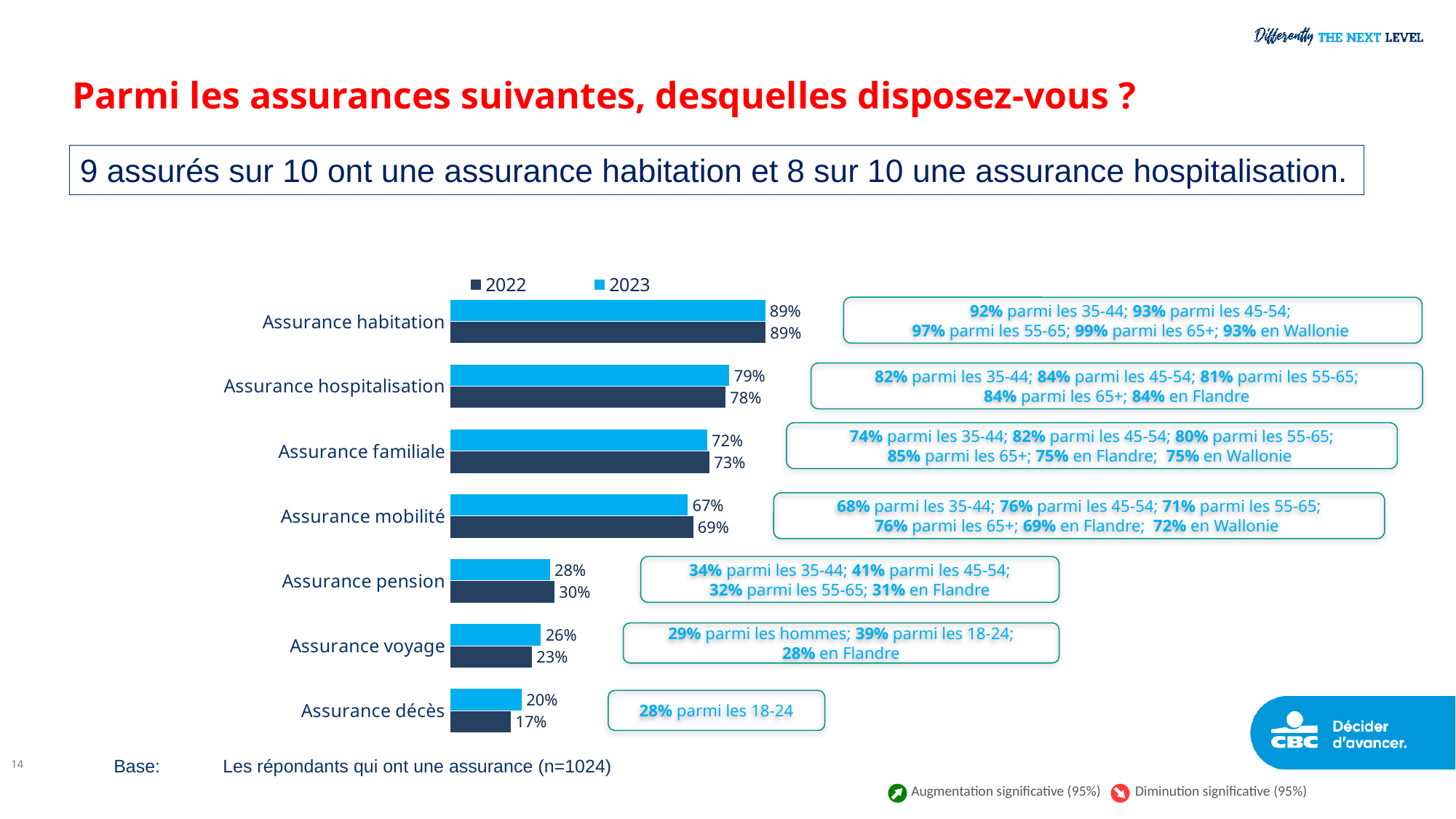
Which category has the highest 2023 value? Assurance habitation Which category has the lowest 2022 value? Assurance décès How many series does the legend list? 2 What is the 2023 value for Assurance hospitalisation? 79% What is the difference between the 2022 and 2023 values for Assurance voyage? 3% What is the 2022 value for Assurance pension? 30% What kind of chart is shown on the slide? Bar chart How many categories does the chart show? 7 Which is larger for Assurance mobilité, the 2022 value or the 2023 value? 2022 What is the difference between the 2023 values for Assurance habitation and Assurance familiale? 17% Which series is shown in dark blue in the legend? 2022 What is the 2023 value for Assurance décès? 20%